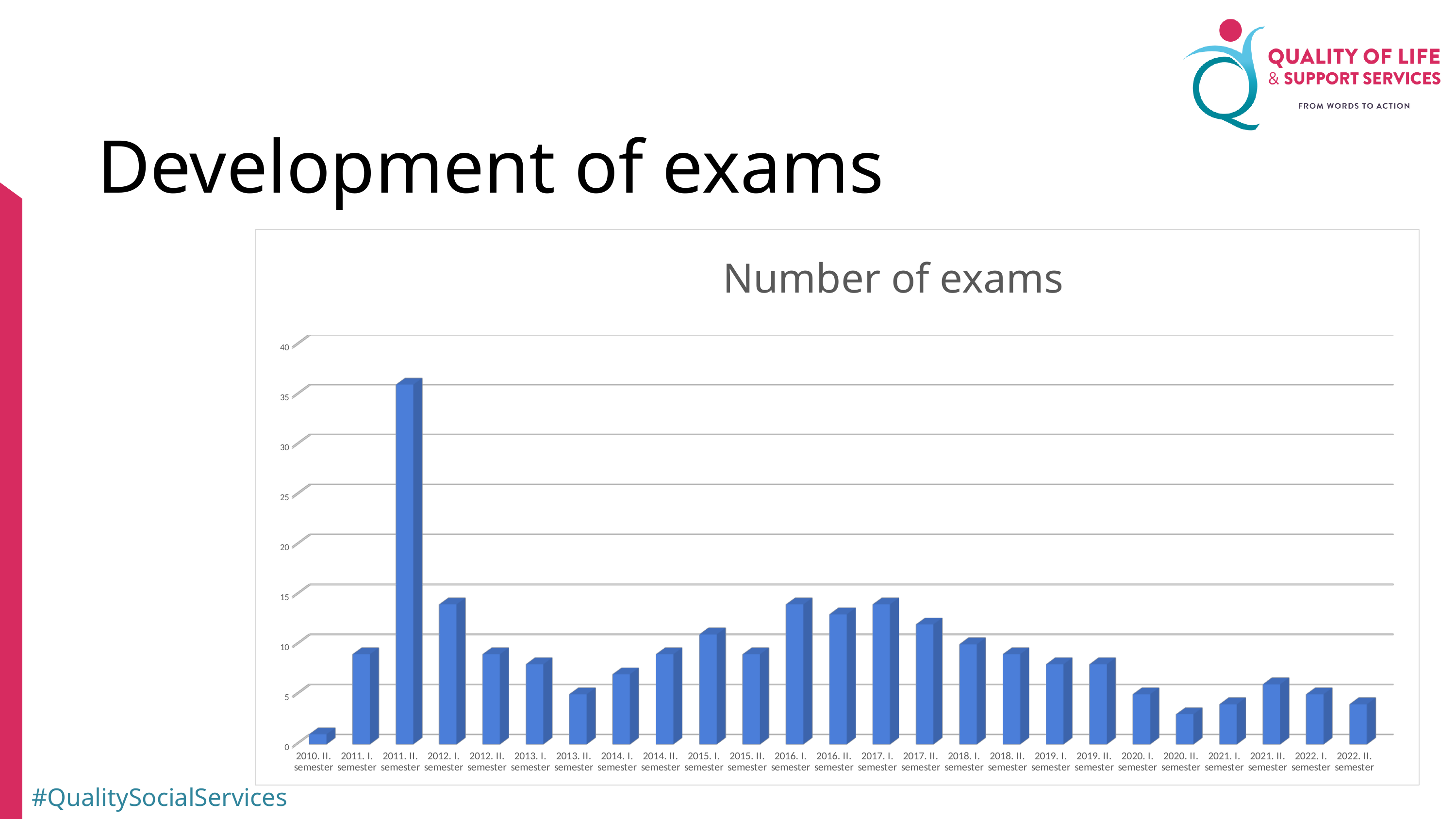
Which semester has the highest number of exams? 2011. II. semester What is the title of the chart? Number of exams Is the value for 2010. II. semester greater or less than 5? less Which has more exams, 2011. II. semester or 2012. I. semester? 2011. II. semester Do the values generally rise or fall from 2017. I. semester to 2020. II. semester? fall Which semester has the lowest number of exams? 2010. II. semester What kind of chart is shown on the slide? Bar chart Which has more exams, 2016. I. semester or 2020. II. semester? 2016. I. semester Is the value for 2011. II. semester greater or less than 30? greater How many semesters (categories) are shown on the x axis of the chart? 25 Is the value for 2016. I. semester greater or less than 10? greater